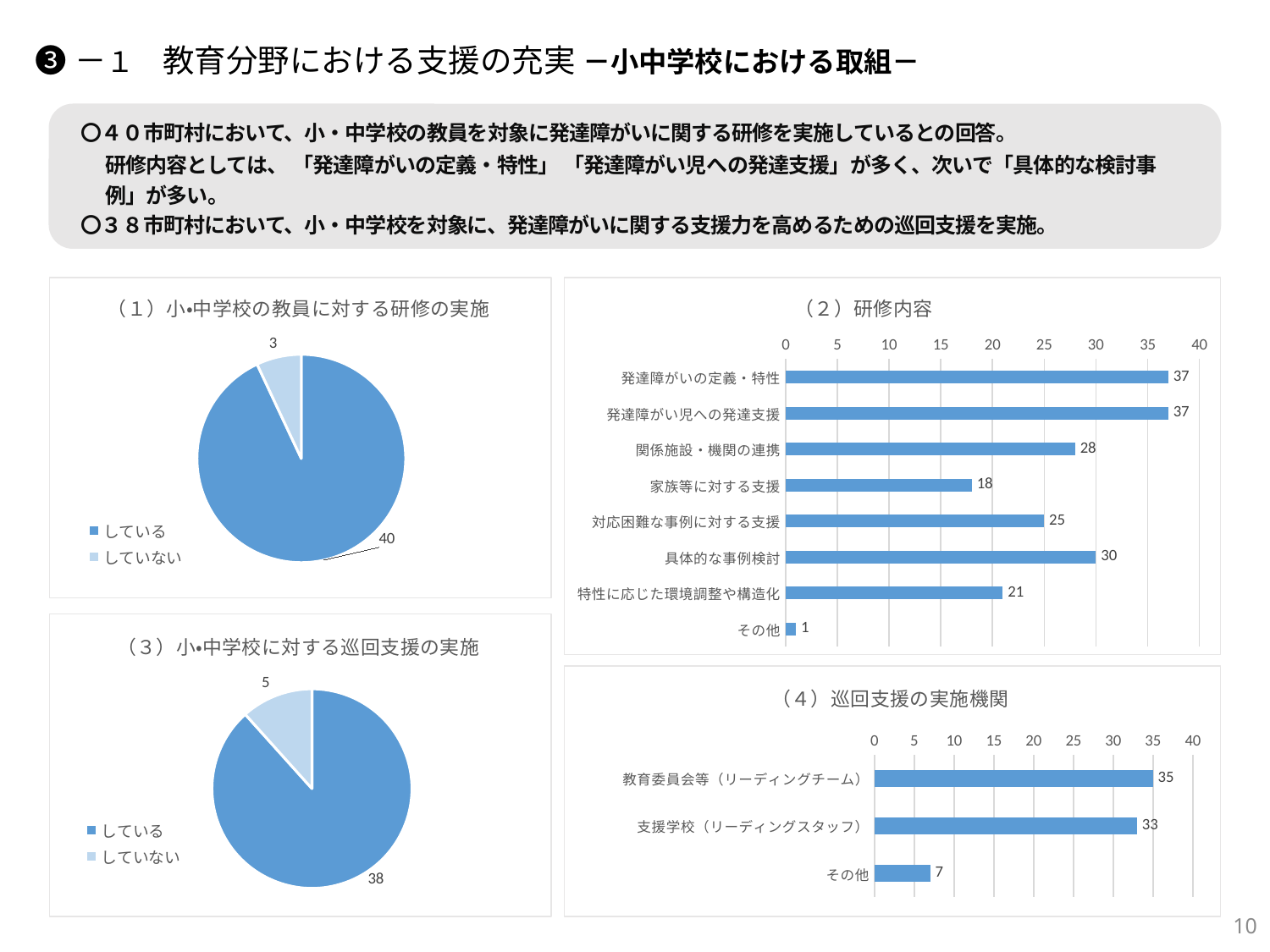
In the chart titled （２）研修内容, which is larger: 家族等に対する支援 or 特性に応じた環境調整や構造化? 特性に応じた環境調整や構造化 What kind of chart is the chart titled （４）巡回支援の実施機関? bar chart What kind of chart is the chart titled （３）小・中学校に対する巡回支援の実施? pie chart In the chart titled （４）巡回支援の実施機関, which category has the highest value? 教育委員会等（リーディングチーム） In the chart titled （４）巡回支援の実施機関, what is the value for 支援学校（リーディングスタッフ）? 33 In the chart titled （２）研修内容, which category has the lowest value? その他 How many categories are shown in the chart titled （２）研修内容? 8 In the chart titled （４）巡回支援の実施機関, what is the difference between 教育委員会等（リーディングチーム） and その他? 28 In the chart titled （２）研修内容, what is the difference between 具体的な事例検討 and 対応困難な事例に対する支援? 5 In the chart titled （１）小・中学校の教員に対する研修の実施, what is the value for していない? 3 In the chart titled （２）研修内容, what is the value for 関係施設・機関の連携? 28 How many series does the legend list in the chart titled （３）小・中学校に対する巡回支援の実施? 2